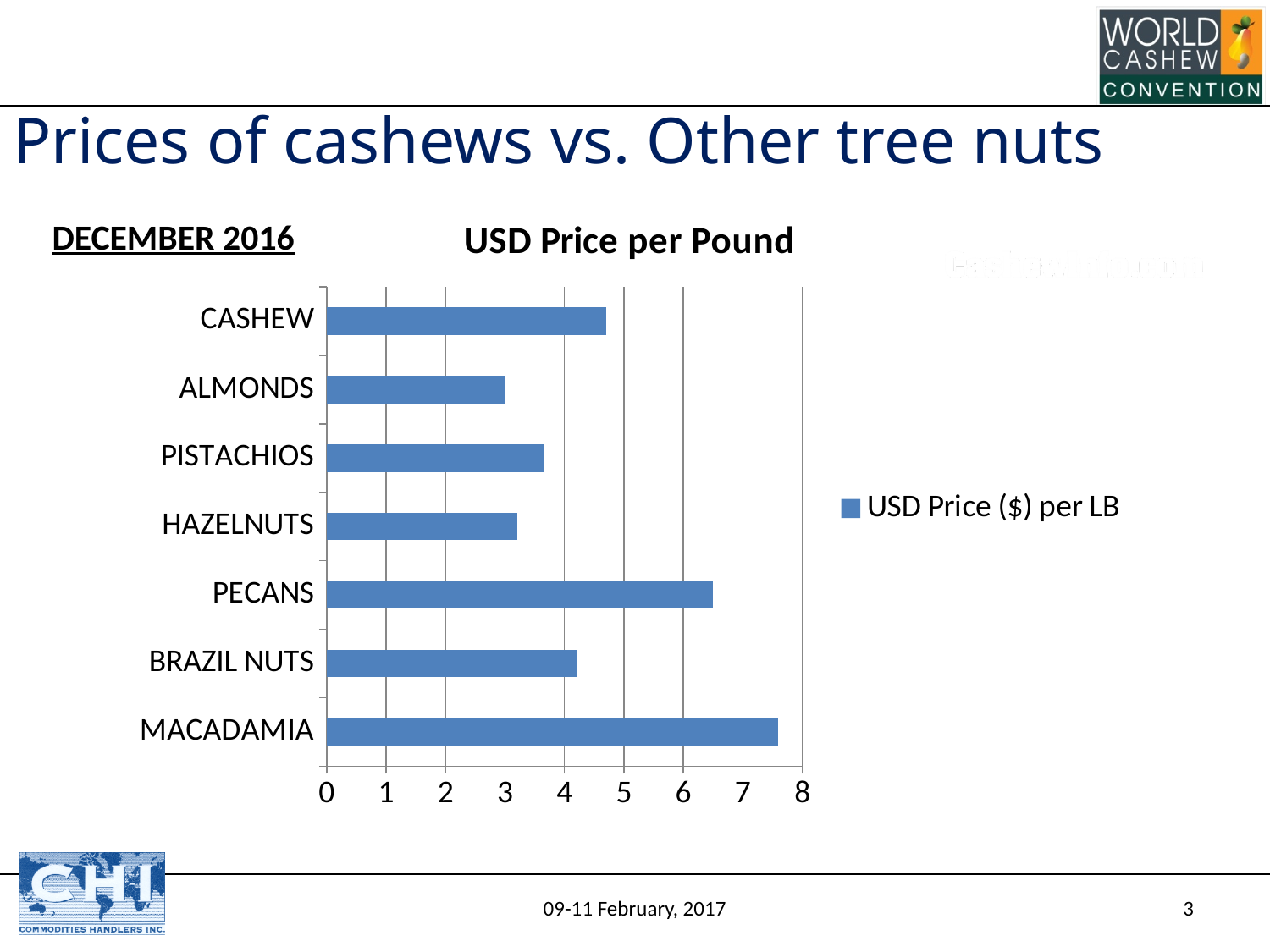
Which tree nut has the highest USD price per pound in the chart? MACADAMIA Is the value for PECANS greater or less than 6? greater Which is priced higher per pound, CASHEW or BRAZIL NUTS? CASHEW How many series does the chart legend list? 1 How many tree nut categories are plotted in the chart? 7 Which is priced higher per pound, PECANS or CASHEW? PECANS Is the value for PISTACHIOS greater or less than 4? less What is the title of the chart? USD Price per Pound Which is priced higher per pound, MACADAMIA or PECANS? MACADAMIA What kind of chart is shown on the slide? bar chart Is the value for MACADAMIA greater or less than 7? greater